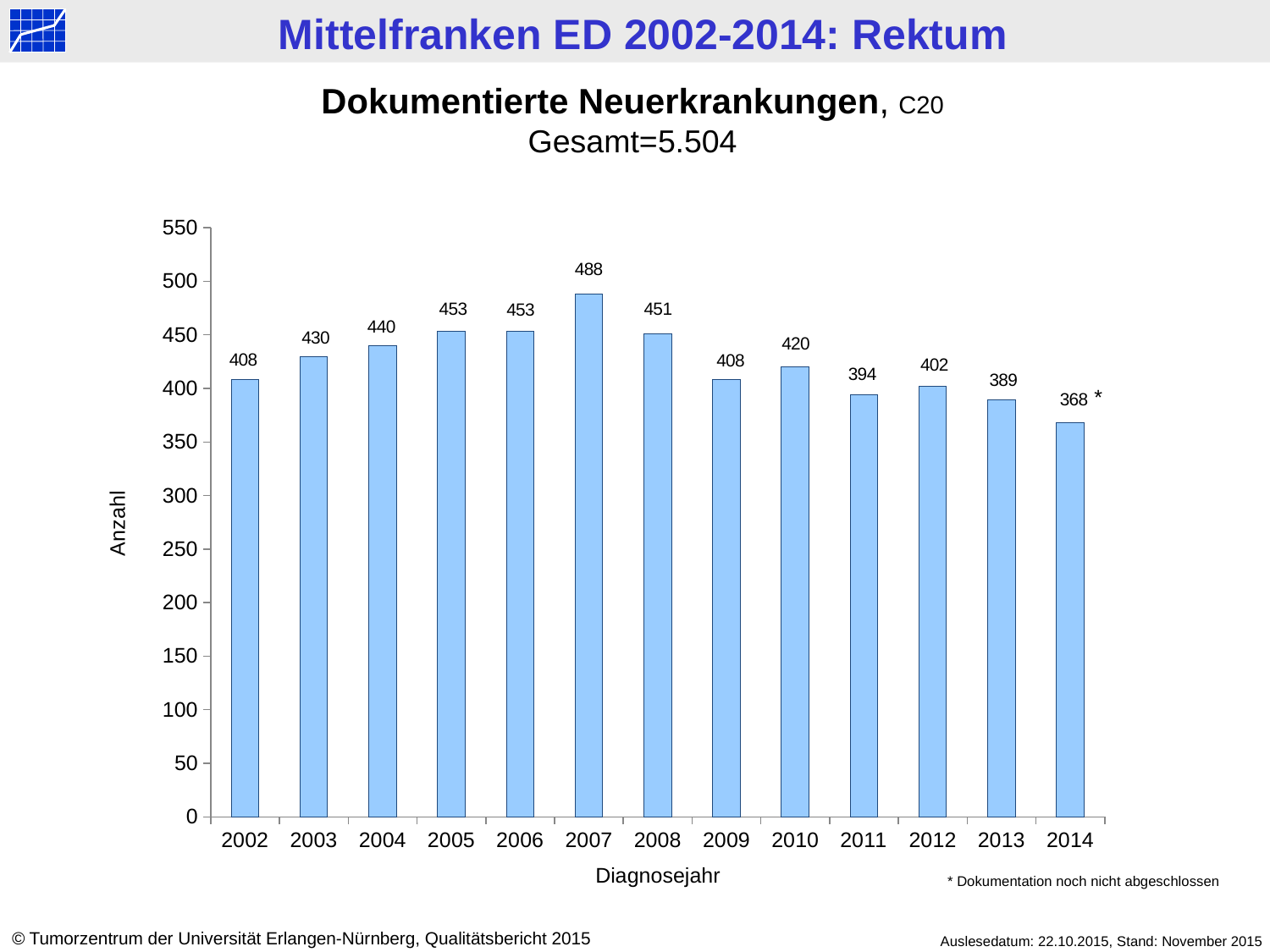
Do the values rise or fall from 2007 to 2014? fall Is the value for 2011 greater or less than 400? less What is the label of the y axis? Anzahl Which year has the lowest value? 2014 What kind of chart is this? bar chart Which year has the highest value? 2007 What is the value for 2007? 488 What total (Gesamt) is stated above the chart? 5.504 Which is larger, the value for 2003 or the value for 2010? 2003 What is the value for 2014? 368 How many years are shown on the x axis? 13 What is the difference between the values for 2007 and 2014? 120